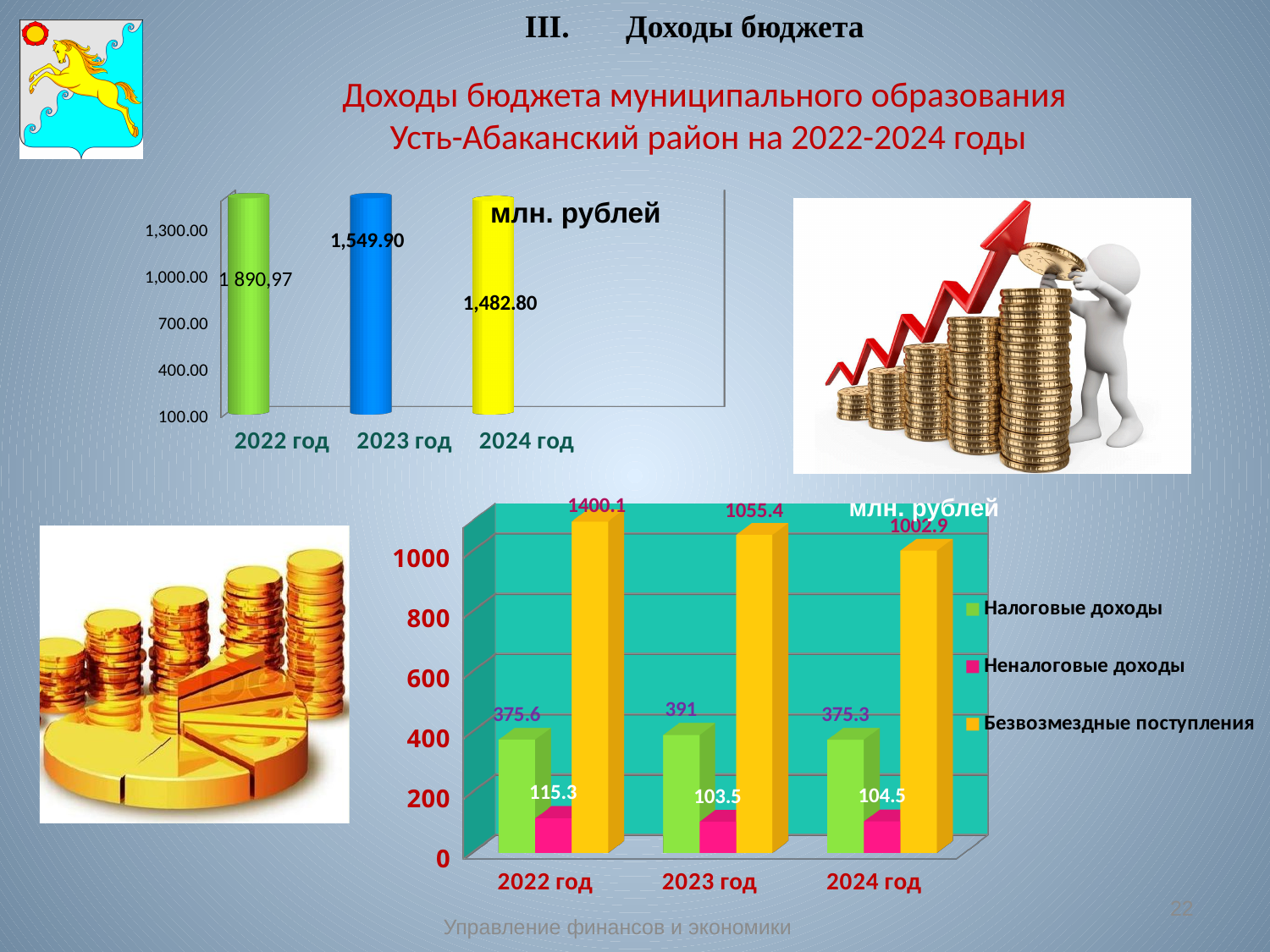
On the top chart, how many years are shown on the x axis? 3 On the bottom chart, what is the difference between Безвозмездные поступления in 2023 год and 2024 год? 52.5 On the top chart, what is the value for 2024 год? 1,482.80 On the top chart, what is the value for 2023 год? 1,549.90 On the bottom chart, in which year is Неналоговые доходы lowest? 2023 год On the bottom chart, in which year is Безвозмездные поступления highest? 2022 год On the bottom chart, how many series does the legend list? 3 On the bottom chart, does Безвозмездные поступления rise or fall from 2022 год to 2024 год? fall On the bottom chart, what is the value of Неналоговые доходы for 2024 год? 104.5 On the bottom chart, what is the value of Налоговые доходы for 2023 год? 391 On the bottom chart, what is the value of Безвозмездные поступления for 2022 год? 1400.1 On the top chart, what unit is stated in the chart's label? млн. рублей